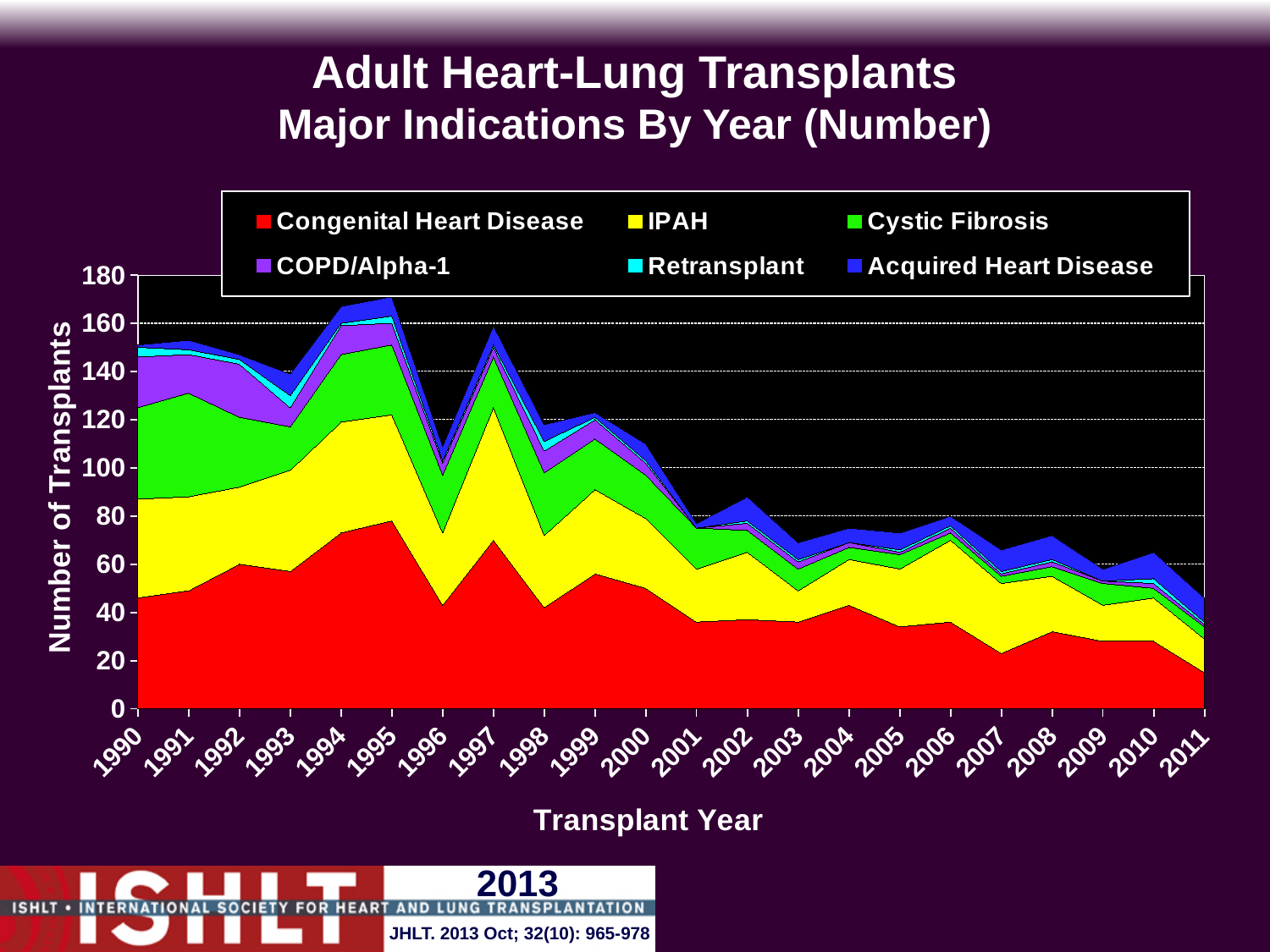
How many transplant years are shown along the x axis? 22 Is the total number of transplants in 2003 greater or less than 80? less What is the first year shown on the x axis? 1990 Is the total number of transplants in 1995 greater or less than 160? greater What kind of chart is shown on the slide? Stacked area chart Does the total number of transplants generally rise or fall from 1990 to 2011? fall Which year has the lowest total number of transplants? 2011 What is the title of the y axis? Number of Transplants Is the total number of transplants in 2011 greater or less than 60? less How many series does the legend list? 6